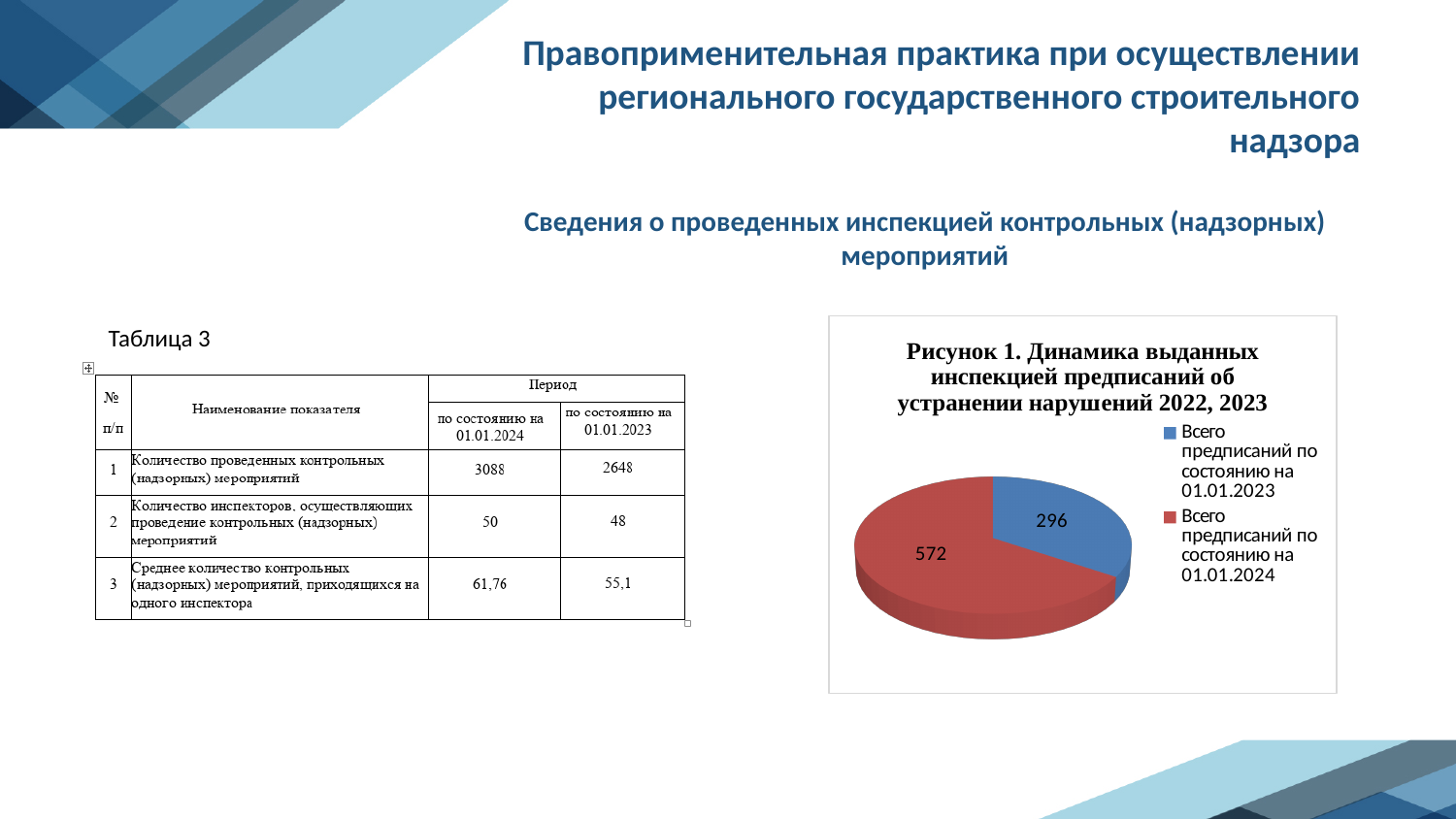
Which is larger: the value for 01.01.2024 or the value for 01.01.2023? 01.01.2024 What is the value for "Всего предписаний по состоянию на 01.01.2023" in the pie chart? 296 What kind of chart is shown on the slide? pie chart How many entries does the legend of the pie chart list? 2 What colour is the slice for "Всего предписаний по состоянию на 01.01.2024"? red Which slice of the pie chart is the smallest? Всего предписаний по состоянию на 01.01.2023 What is the difference between the number of предписаний as of 01.01.2024 and as of 01.01.2023? 276 How many slices does the pie chart have? 2 Which slice of the pie chart is the largest? Всего предписаний по состоянию на 01.01.2024 What is the value for "Всего предписаний по состоянию на 01.01.2024" in the pie chart? 572 What is the total of the two values shown in the pie chart? 868 What is the title of the pie chart? Рисунок 1. Динамика выданных инспекцией предписаний об устранении нарушений 2022, 2023